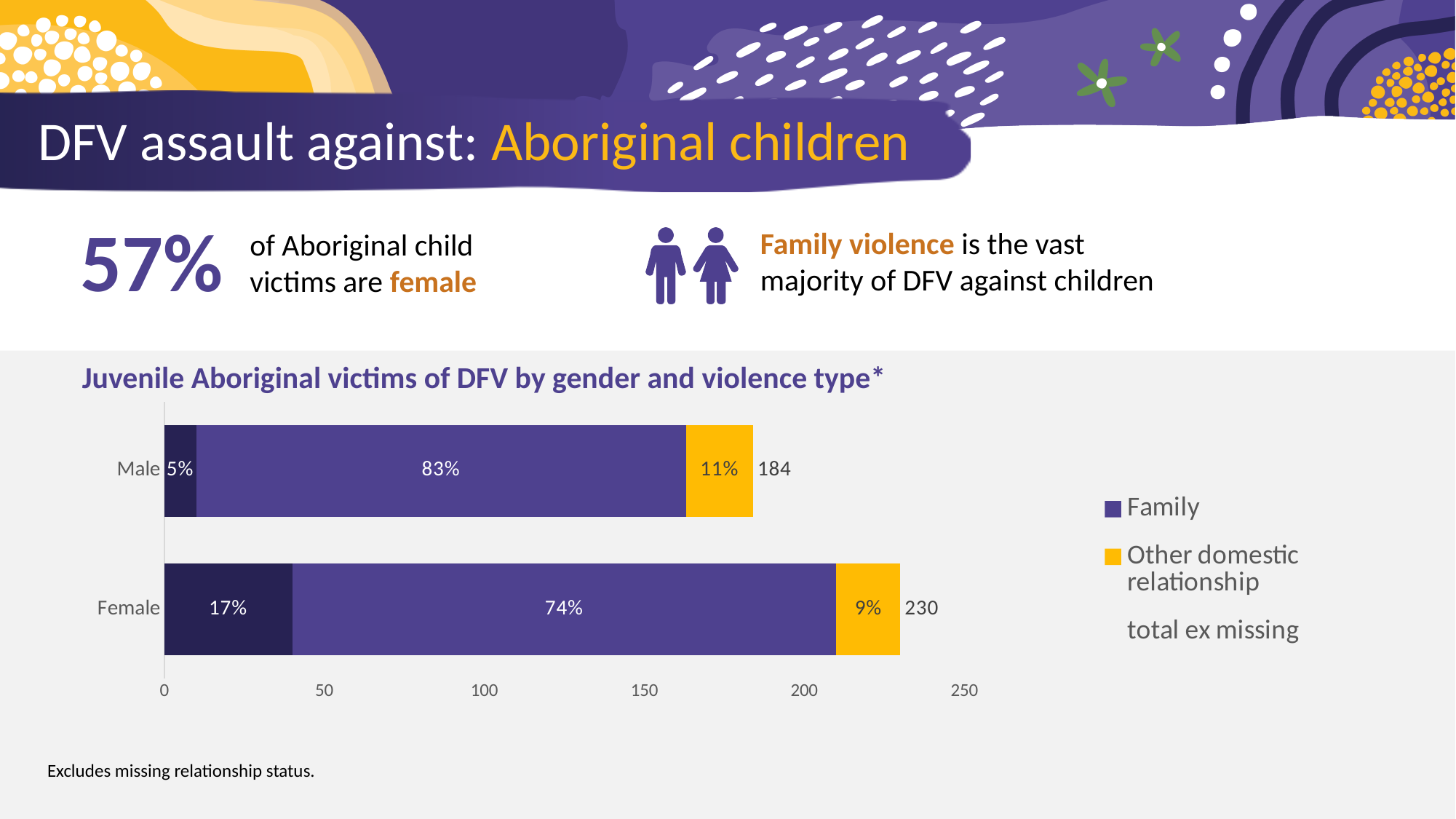
How many entries does the chart legend list? 3 What percentage of the Male bar is labelled Other domestic relationship? 11% What is the difference between the Female total (230) and the Male total (184)? 46 What percentage of Female juvenile Aboriginal victims is labelled as Family violence? 74% What is the title of the chart? Juvenile Aboriginal victims of DFV by gender and violence type* What is the total number shown at the end of the Male bar? 184 What percentage of the Female bar is labelled Other domestic relationship? 9% What is the total number shown at the end of the Female bar? 230 Which gender has the larger total number of juvenile Aboriginal victims? Female What percentage of Male juvenile Aboriginal victims is labelled as Family violence? 83% Is the total for Male greater or less than 200? less What kind of chart is shown on the slide? bar chart